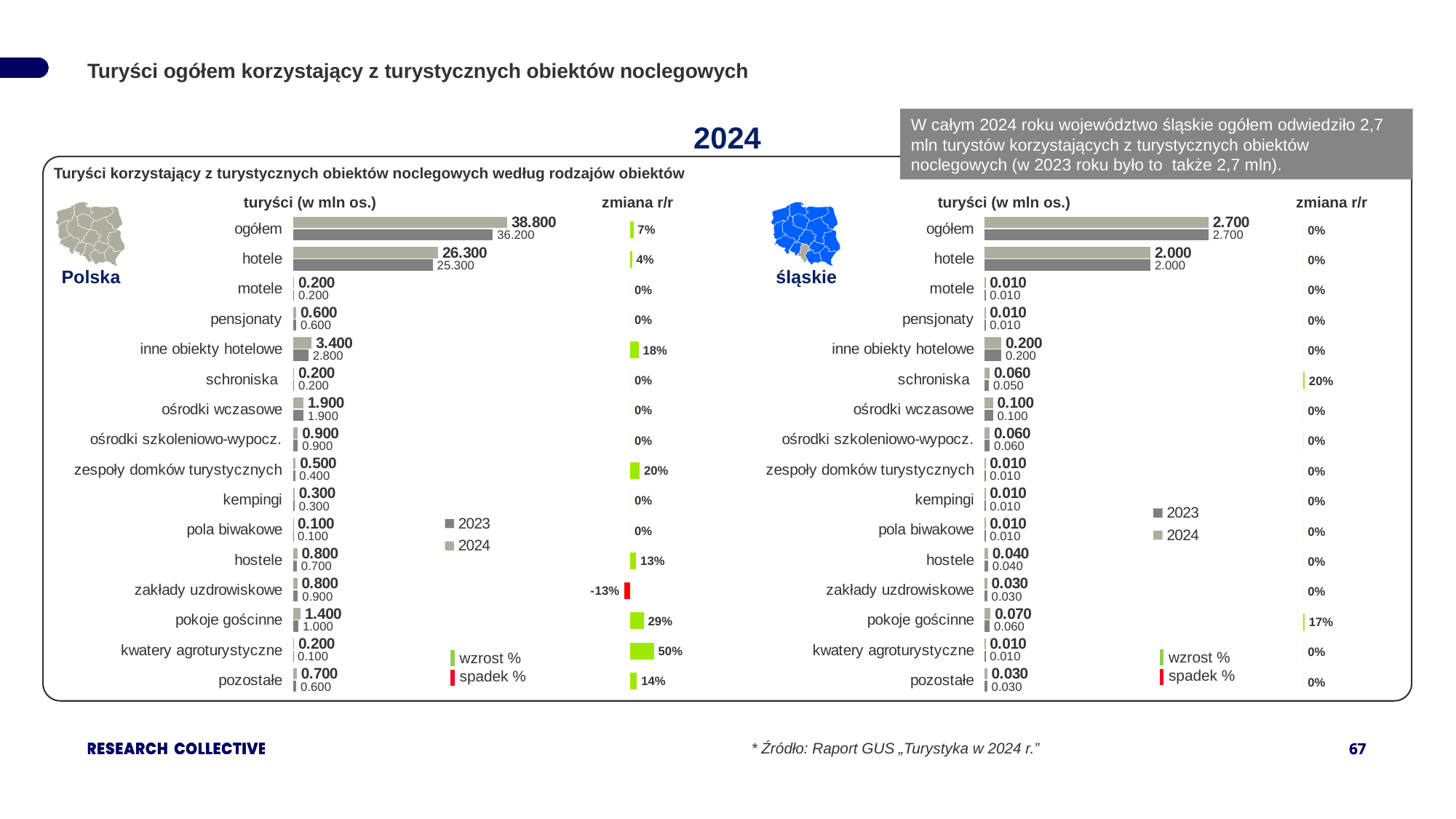
In the Polska chart, which category has a negative zmiana r/r? zakłady uzdrowiskowe How many categories (rows) are listed in the Polska chart? 16 What type of chart is used for turyści (w mln os.) in the Polska chart? bar chart How many series does the legend of the śląskie chart list? 2 In the śląskie chart, what is the 2024 value for hotele? 2.000 In the Polska chart, which is larger for inne obiekty hotelowe: the 2024 value or the 2023 value? 2024 In the śląskie chart, what is the zmiana r/r for pokoje gościnne? 17% In the Polska chart, what is the difference between the 2024 and 2023 values for ogółem? 2.600 In the Polska chart, what is the 2023 value for hotele? 25.300 In the śląskie chart, which category has the highest zmiana r/r? schroniska In the Polska chart, what is the zmiana r/r for kwatery agroturystyczne? 50% In the Polska chart, what is the 2024 value for ogółem (in mln os.)? 38.800